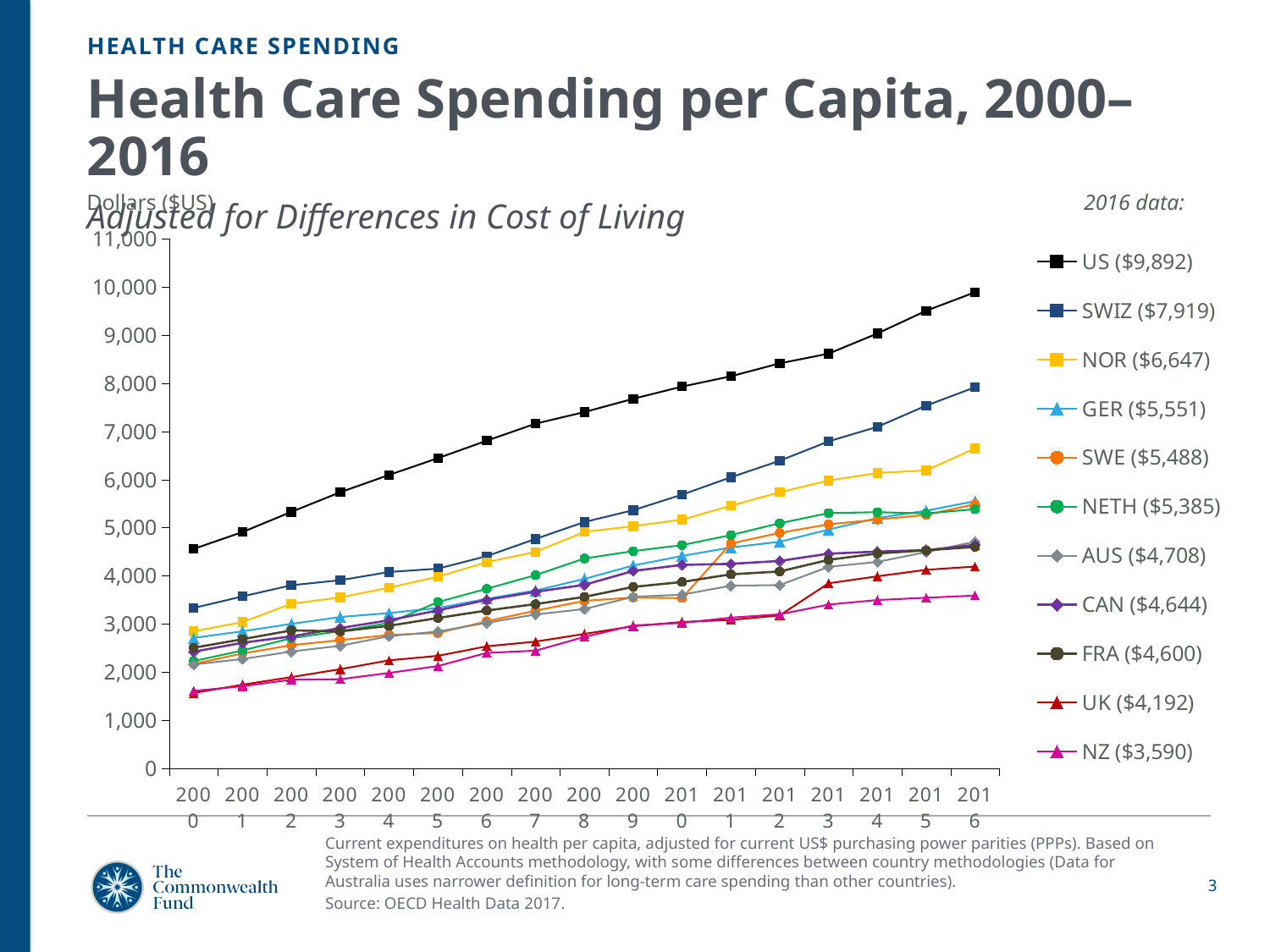
According to the legend, what was health care spending per capita in the US in 2016? $9,892 How many countries (series) does the legend list? 11 Which country had the highest health care spending per capita in 2016? US Which country had the lowest health care spending per capita in 2016? NZ According to the legend, what was health care spending per capita in Switzerland (SWIZ) in 2016? $7,919 What type of chart is shown on the slide? Line chart Does the US line rise or fall from 2000 to 2016? rise What is the source cited for the chart data? OECD Health Data 2017 What is the difference between the 2016 values for the US and SWIZ? $1,973 Is the value for the US in 2000 greater or less than 5,000? less In 2016, which had the larger value, GER or SWE? GER What is the difference between the 2016 values for the UK and NZ? $602